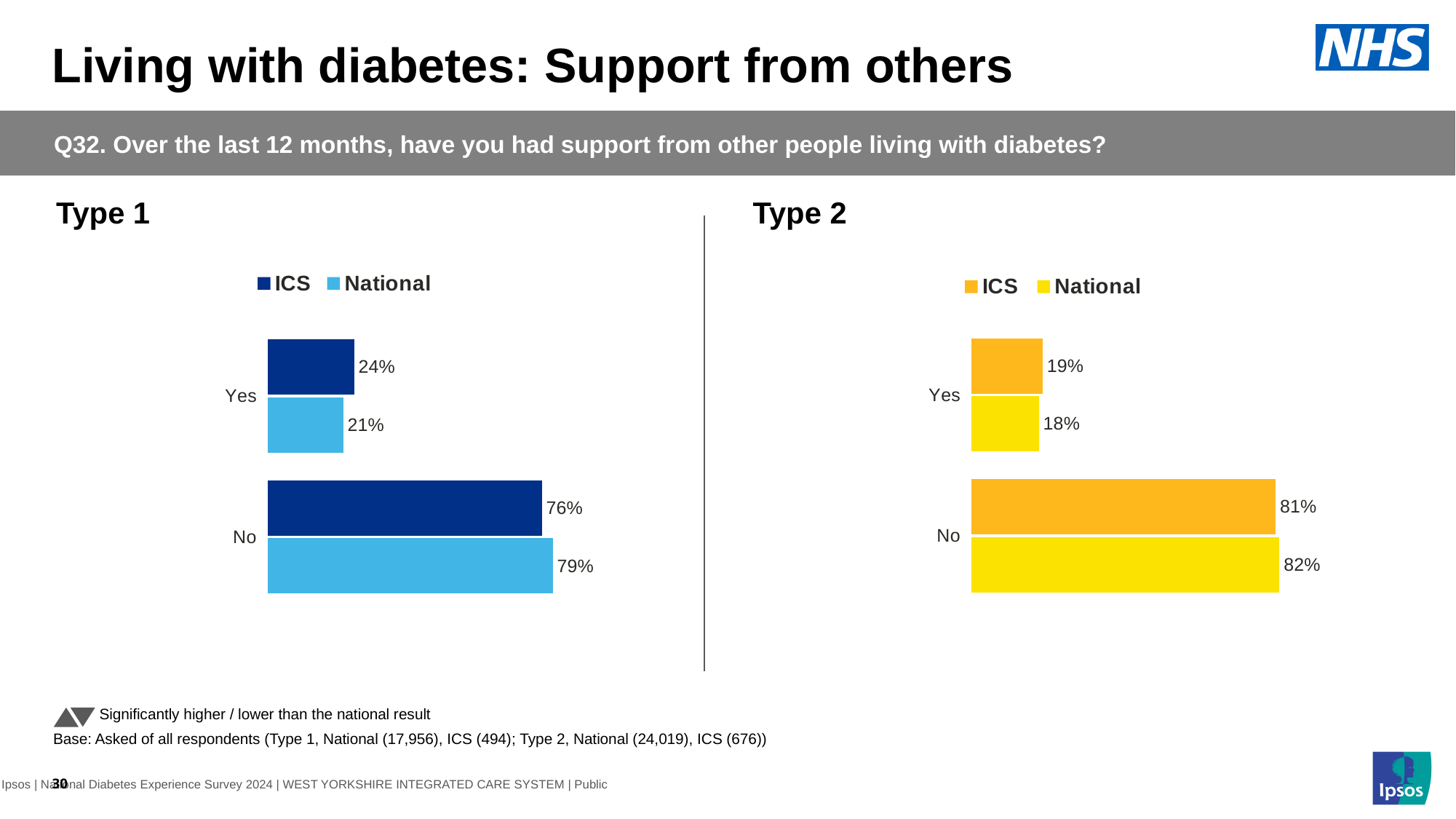
In the Type 1 chart, which is larger for Yes, the ICS value or the National value? ICS In the Type 2 chart, which is larger for No, the ICS value or the National value? National In the Type 2 chart, what is the National value for Yes? 18% In the Type 1 chart, what is the ICS value for Yes? 24% In the Type 1 chart, what is the difference between the ICS and National values for No? 3 percentage points How many series does the legend of the Type 1 chart list? 2 In the Type 2 chart, what is the difference between the ICS and National values for Yes? 1 percentage point In the Type 2 chart, what is the ICS value for No? 81% In the Type 1 chart, what is the National value for No? 79% In the Type 2 chart, which response category has the highest ICS value? No What kind of chart is the Type 1 chart? Bar chart How many response categories are shown in the Type 2 chart? 2